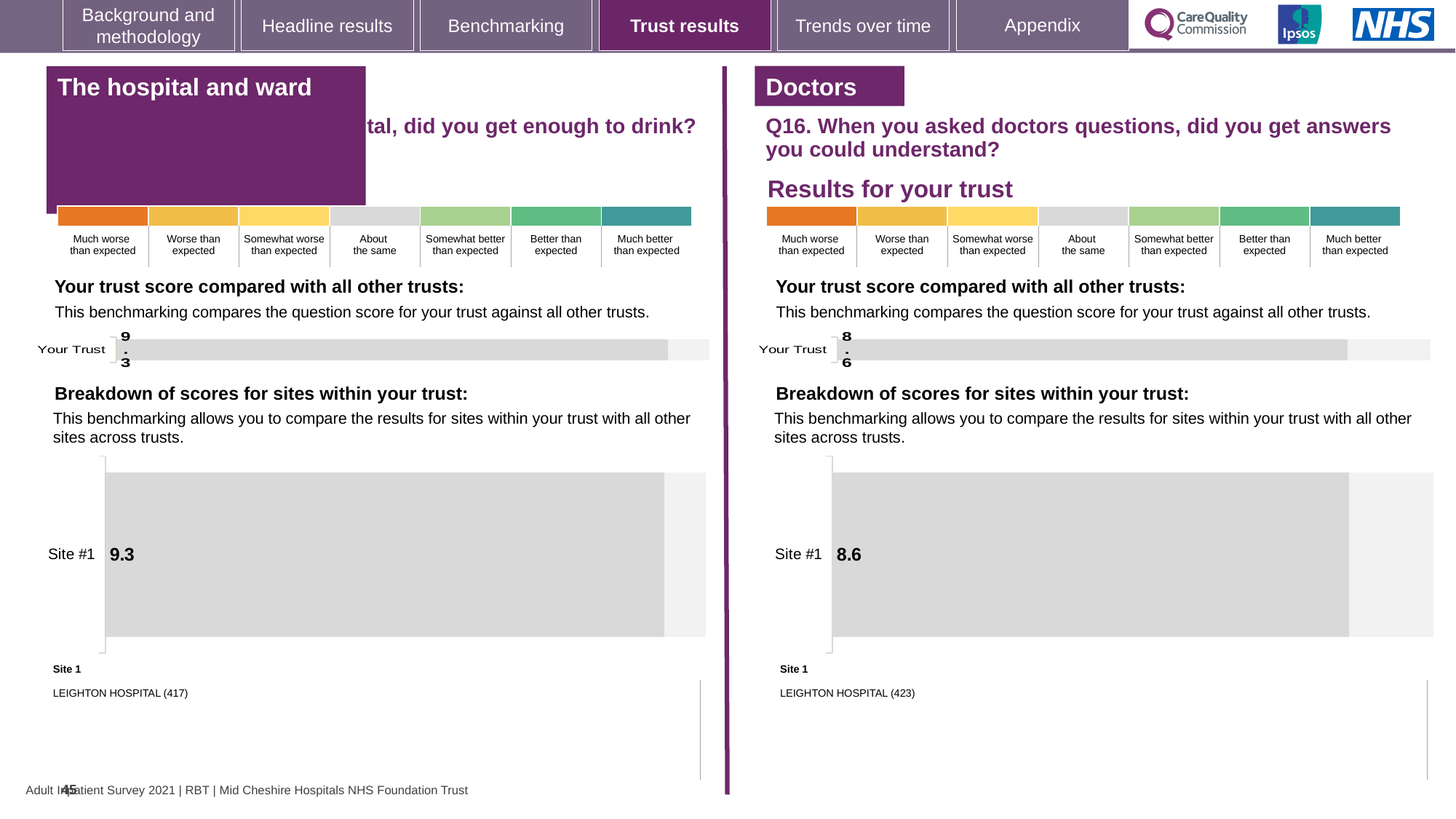
In the left-hand section, which hospital is listed as Site 1 below the breakdown chart? LEIGHTON HOSPITAL (417) How many sites are shown in the site breakdown chart under Q16 in the Doctors section? 1 In the 'Your Trust' chart under Q16 in the Doctors section, what is the trust score shown? 8.6 Which 'Your Trust' score is larger: the one in the left-hand section (The hospital and ward) or the one under Q16 (Doctors)? The hospital and ward (9.3) What kind of chart is used to show the Site #1 score in the left-hand breakdown chart? Bar chart How many bars are plotted in the 'Your Trust' chart on the left side of the slide? 1 How many categories does the colour scale above the Q16 charts show, from 'Much worse than expected' to 'Much better than expected'? 7 In the site breakdown chart on the left side of the slide, what is the score for Site #1? 9.3 In the site breakdown chart under Q16 in the Doctors section, what is the score for Site #1? 8.6 What is the difference between the Site #1 score in the left-hand breakdown chart and the Site #1 score in the Q16 breakdown chart? 0.7 In the 'Your Trust' chart on the left side of the slide (The hospital and ward section), what is the trust score shown? 9.3